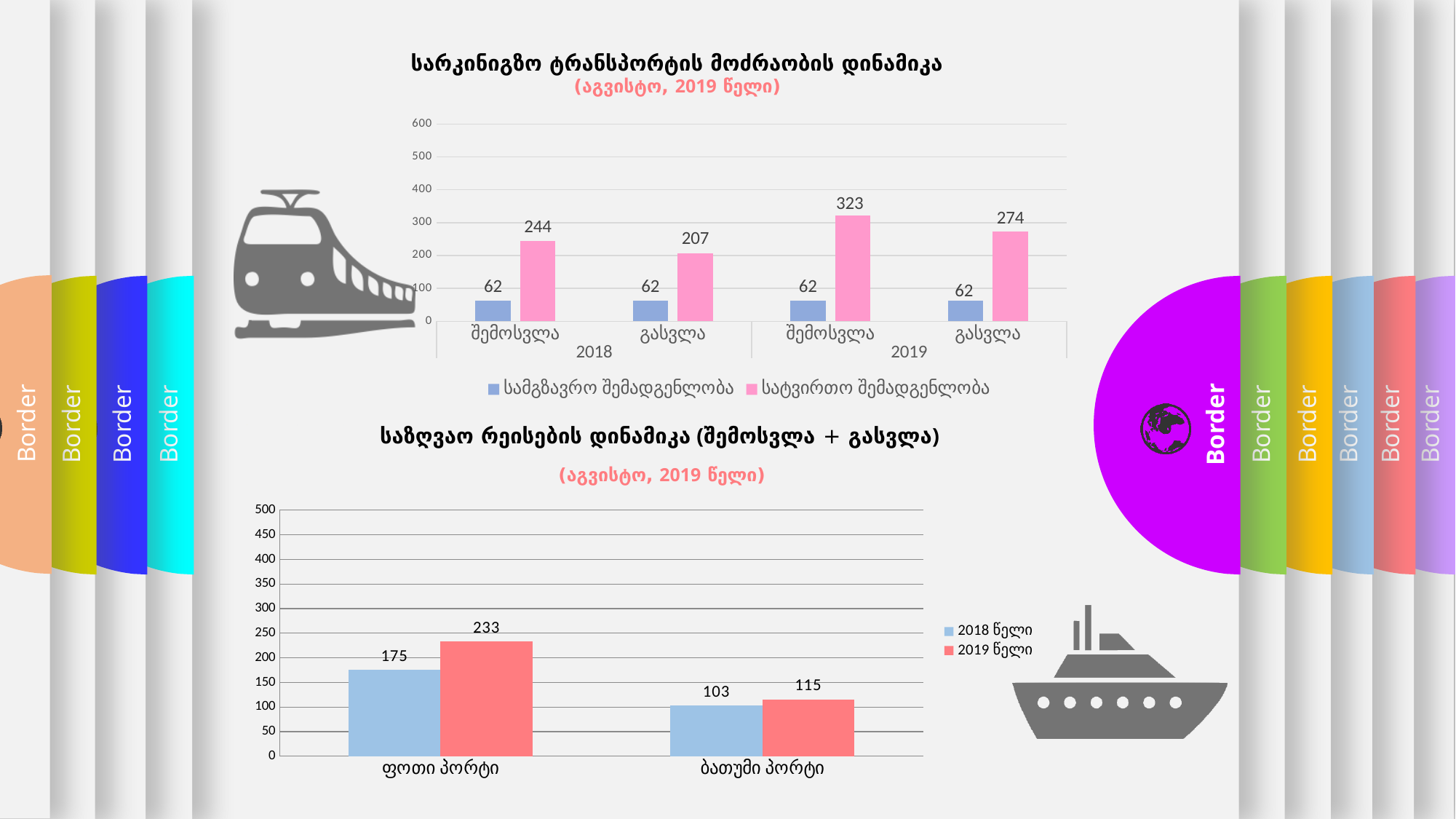
In the top chart, how many series does the legend list? 2 In the bottom chart, which port has the larger value for 2019 წელი, ფოთი პორტი or ბათუმი პორტი? ფოთი პორტი In the top chart, which category has the highest value for სატვირთო შემადგენლობა? შემოსვლა 2019 In the top chart, what is the value of სამგზავრო შემადგენლობა for შემოსვლა in 2018? 62 In the top chart, what colour are the bars for სატვირთო შემადგენლობა? Pink In the bottom chart, what is the difference between the 2019 წელი and 2018 წელი values for ფოთი პორტი? 58 In the bottom chart (საზღვაო რეისების დინამიკა), what is the value for ფოთი პორტი in 2019 წელი? 233 In the top chart (სარკინიგზო ტრანსპორტის მოძრაობის დინამიკა), what is the value of სატვირთო შემადგენლობა for შემოსვლა in 2019? 323 What type of chart is the bottom chart? Bar chart In the top chart, what is the value of სატვირთო შემადგენლობა for გასვლა in 2018? 207 In the top chart, what is the difference between სატვირთო შემადგენლობა for შემოსვლა in 2019 and შემოსვლა in 2018? 79 In the bottom chart, what is the value for ბათუმი პორტი in 2018 წელი? 103